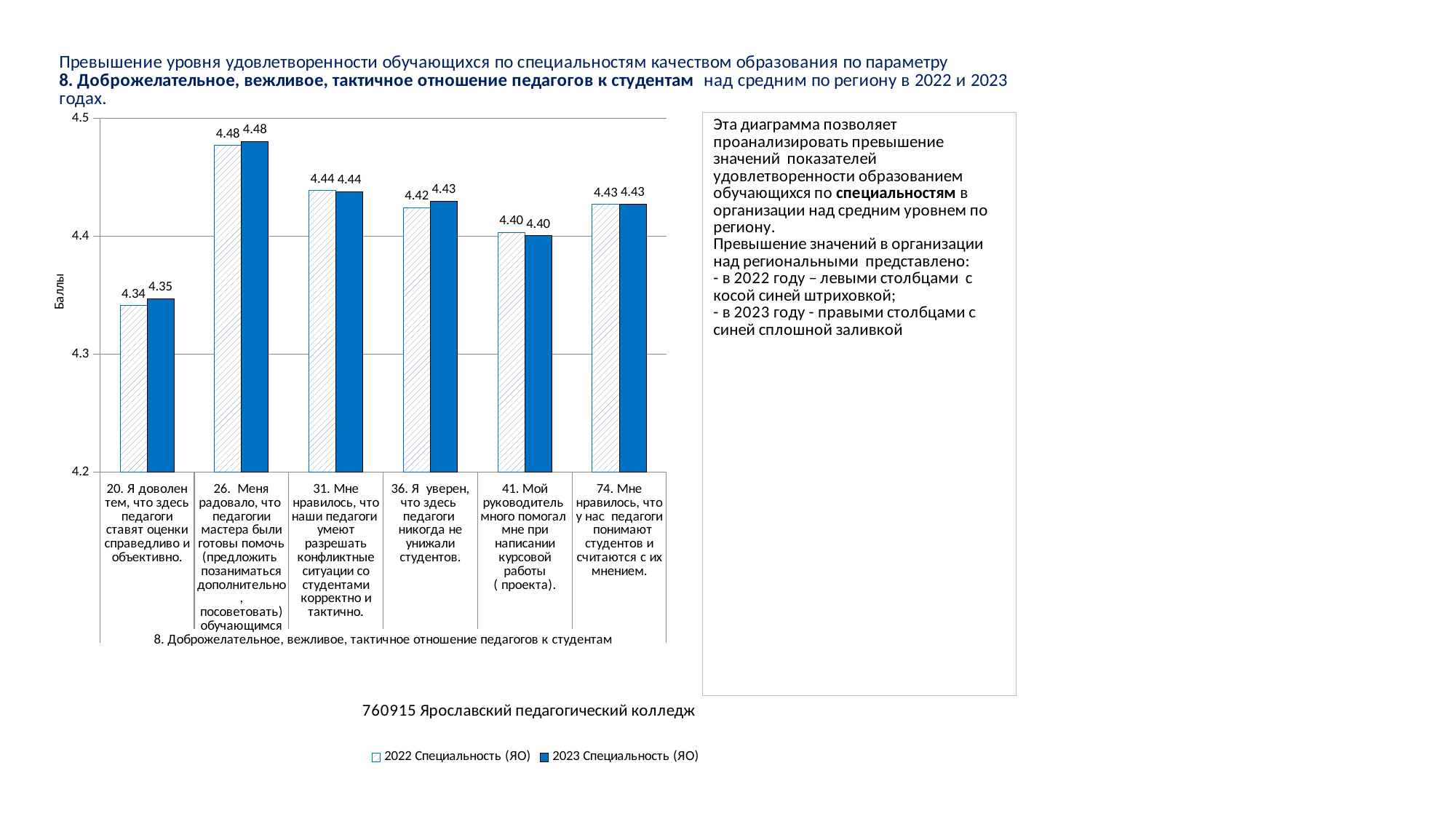
What is the 2023 Специальность (ЯО) value for category 41 (Мой руководитель много помогал мне при написании курсовой работы)? 4.40 Is the 2022 Специальность (ЯО) value for category 74 greater or less than 4.4? greater What is the 2022 Специальность (ЯО) value for category 20 (Я доволен тем, что здесь педагоги ставят оценки справедливо и объективно)? 4.34 What is the label of the vertical axis of the chart? Баллы Which category has the lowest 2022 Специальность (ЯО) value? 20. Я доволен тем, что здесь педагоги ставят оценки справедливо и объективно How many series does the chart legend list? 2 Which category has the highest 2023 Специальность (ЯО) value? 26. Меня радовало, что педагоги мастера были готовы помочь How many categories (questions) are plotted on the x axis of the chart? 6 What is the 2023 Специальность (ЯО) value for category 36 (Я уверен, что здесь педагоги никогда не унижали студентов)? 4.43 Which is larger: the 2022 Специальность (ЯО) value for category 31 or for category 41? category 31 (4.44) What type of chart is shown on the slide? bar chart What is the difference between the 2023 Специальность (ЯО) values for category 26 and category 20? 0.13